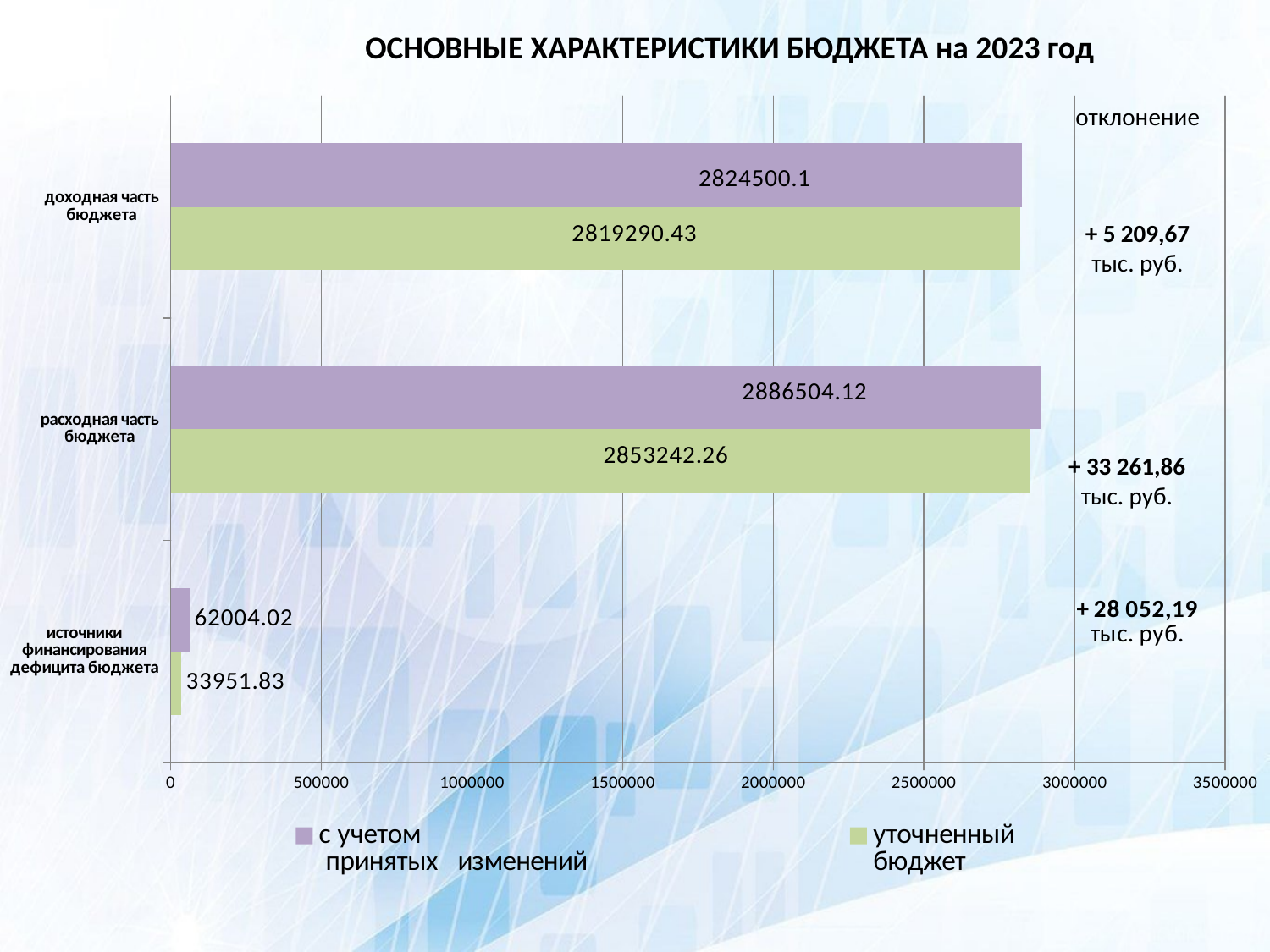
What is the value for 'источники финансирования дефицита бюджета' in the 'с учетом принятых изменений' series? 62004.02 What is the difference between the 'с учетом принятых изменений' and 'уточненный бюджет' values for 'источники финансирования дефицита бюджета'? 28052.19 How many series does the legend list? 2 What is the value for 'доходная часть бюджета' in the 'с учетом принятых изменений' series? 2824500.1 Is the 'уточненный бюджет' value for 'доходная часть бюджета' greater or less than 2500000? greater What is the value for 'источники финансирования дефицита бюджета' in the 'уточненный бюджет' series? 33951.83 Which category has the lowest value in the 'уточненный бюджет' series? источники финансирования дефицита бюджета Which category has the highest value in the 'с учетом принятых изменений' series? расходная часть бюджета How many categories are shown on the chart? 3 For 'источники финансирования дефицита бюджета', which series has the larger value: 'с учетом принятых изменений' or 'уточненный бюджет'? с учетом принятых изменений What is the value for 'расходная часть бюджета' in the 'уточненный бюджет' series? 2853242.26 What is the difference between the 'с учетом принятых изменений' and 'уточненный бюджет' values for 'расходная часть бюджета'? 33261.86